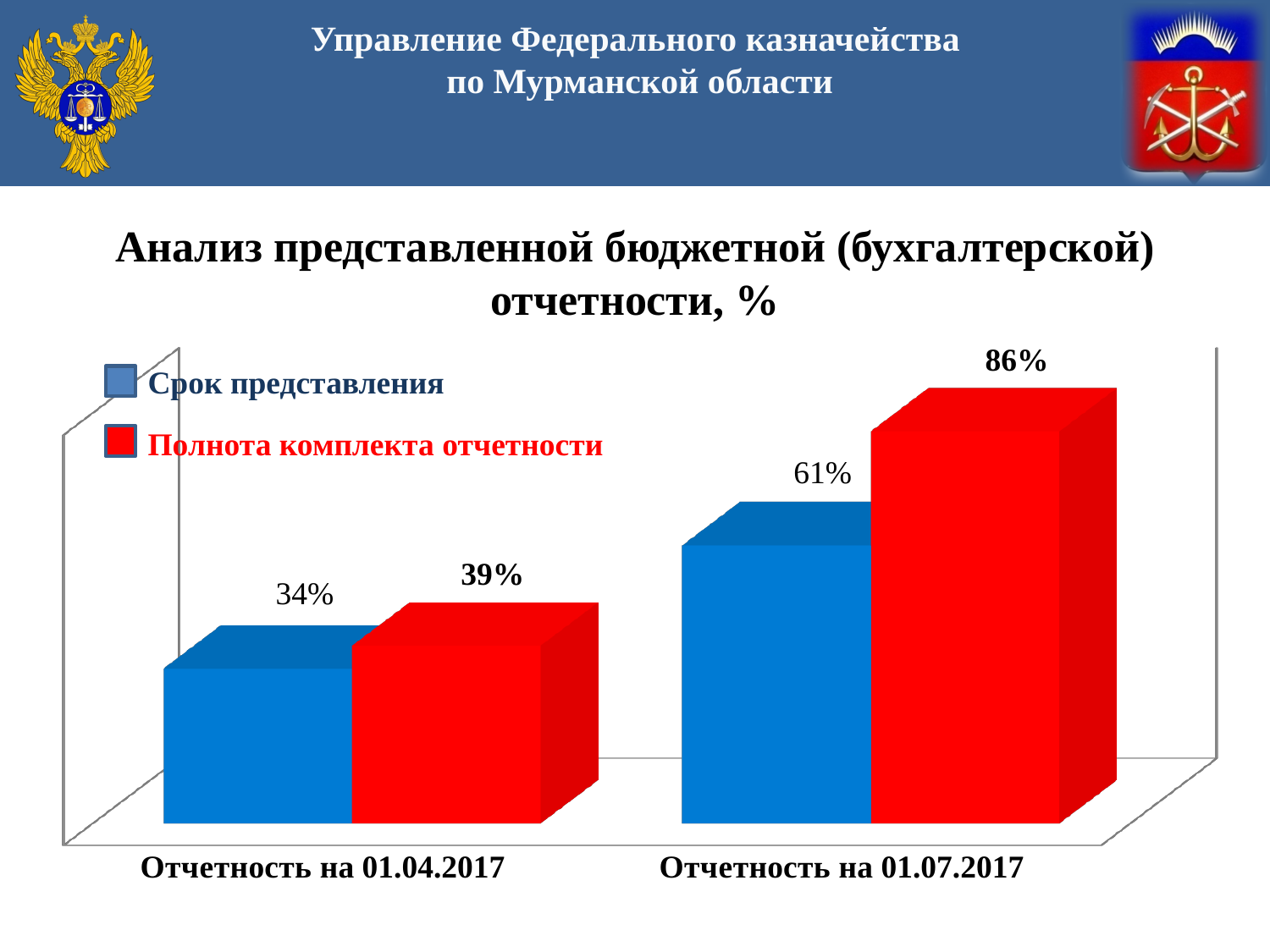
By how much did "Срок представления" change from "Отчетность на 01.04.2017" to "Отчетность на 01.07.2017"? 27% What is the difference between "Полнота комплекта отчетности" and "Срок представления" for "Отчетность на 01.07.2017"? 25% What is the value of "Полнота комплекта отчетности" for "Отчетность на 01.07.2017"? 86% What is the value of "Срок представления" for "Отчетность на 01.07.2017"? 61% How many series does the legend list? 2 What is the value of "Срок представления" for "Отчетность на 01.04.2017"? 34% Which is larger for "Отчетность на 01.04.2017": "Срок представления" or "Полнота комплекта отчетности"? Полнота комплекта отчетности Which category has the lowest value for "Срок представления"? Отчетность на 01.04.2017 What kind of chart is shown on the slide? Bar chart What is the value of "Полнота комплекта отчетности" for "Отчетность на 01.04.2017"? 39% Which category has the highest value for "Полнота комплекта отчетности"? Отчетность на 01.07.2017 How many categories are shown on the x axis? 2